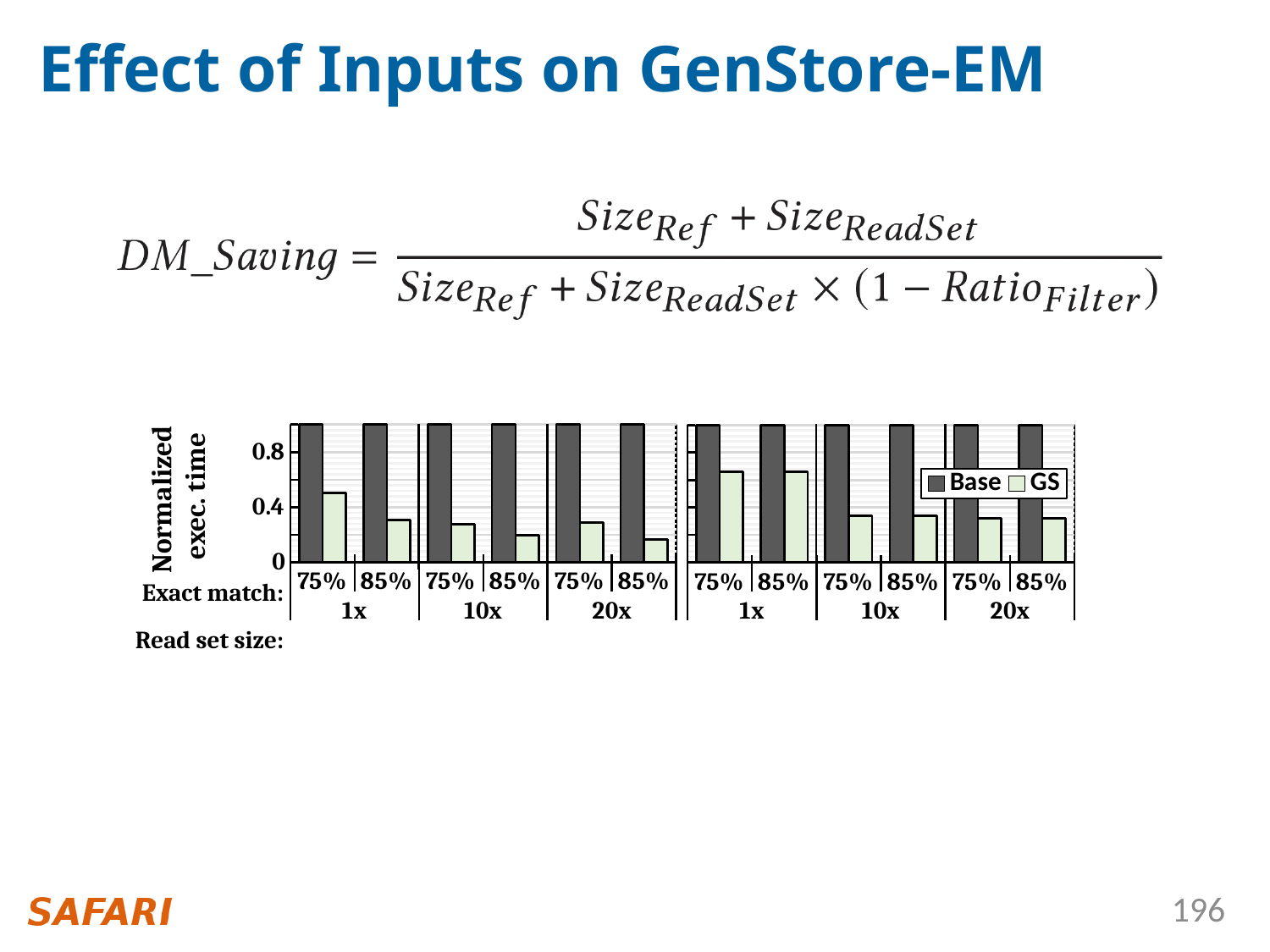
What are the two series named in the chart legend? Base and GS In the left panel of the chart, which is larger for 1x read set size: the GS value at 75% exact match or at 85% exact match? 75% What kind of chart is shown on the slide? bar chart How many series does the chart legend list? 2 What is the label of the chart's y axis? Normalized exec. time In the left panel of the chart, is the GS value for 20x read set size at 85% exact match greater or less than 0.4? less In the left panel of the chart, is the GS value for 1x read set size at 75% exact match greater or less than 0.4? greater How many read set size groups are shown in the left panel of the chart? 3 In the left panel of the chart, is the GS value for 10x read set size at 85% exact match greater or less than 0.4? less In the left panel of the chart, which read set size and exact match combination has the lowest GS value? 20x, 85%